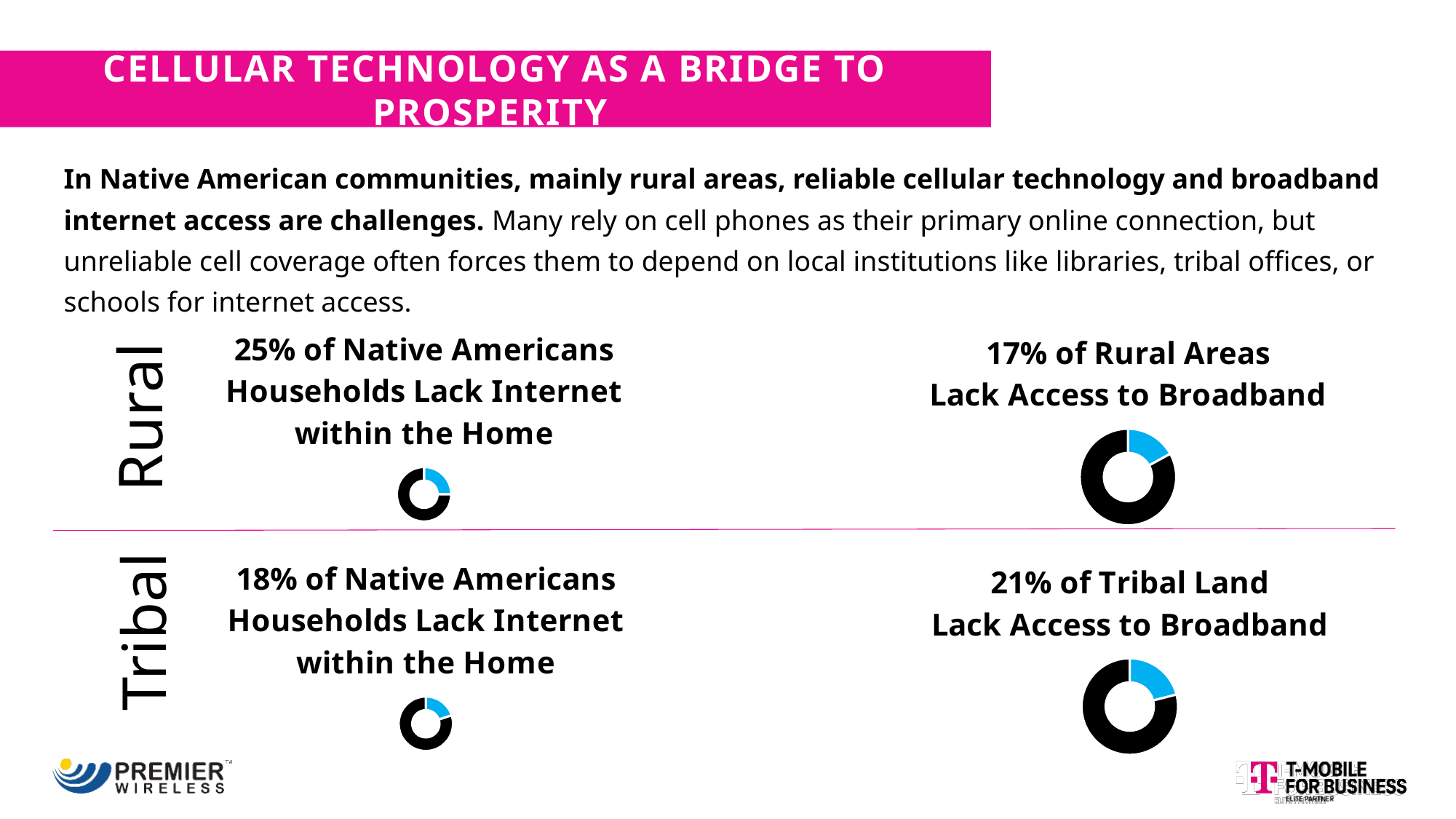
What is the difference between the percentage of Native American households lacking internet in the Rural row and in the Tribal row? 7% Which of the four donut charts shows the highest percentage? 25% of Native Americans Households Lack Internet within the Home (Rural) On the bottom-left donut chart in the Tribal row, what percentage of Native American households lack internet within the home? 18% What colour is used for the highlighted slice in each donut chart? Blue Which of the four donut charts shows the lowest percentage? 17% of Rural Areas Lack Access to Broadband Which is larger: the share of rural areas lacking broadband access or the share of tribal land lacking broadband access? Tribal land (21%) How many donut charts are shown on the slide? 4 What kind of chart is used to show each of the four percentages on the slide? Donut (pie) chart On the top-right donut chart in the Rural row, what percentage of rural areas lack access to broadband? 17% On the bottom-right donut chart in the Tribal row, what percentage of tribal land lacks access to broadband? 21% What is the difference between the percentage of tribal land lacking broadband and the percentage of rural areas lacking broadband? 4% On the top-left donut chart in the Rural row, what percentage of Native American households lack internet within the home? 25%